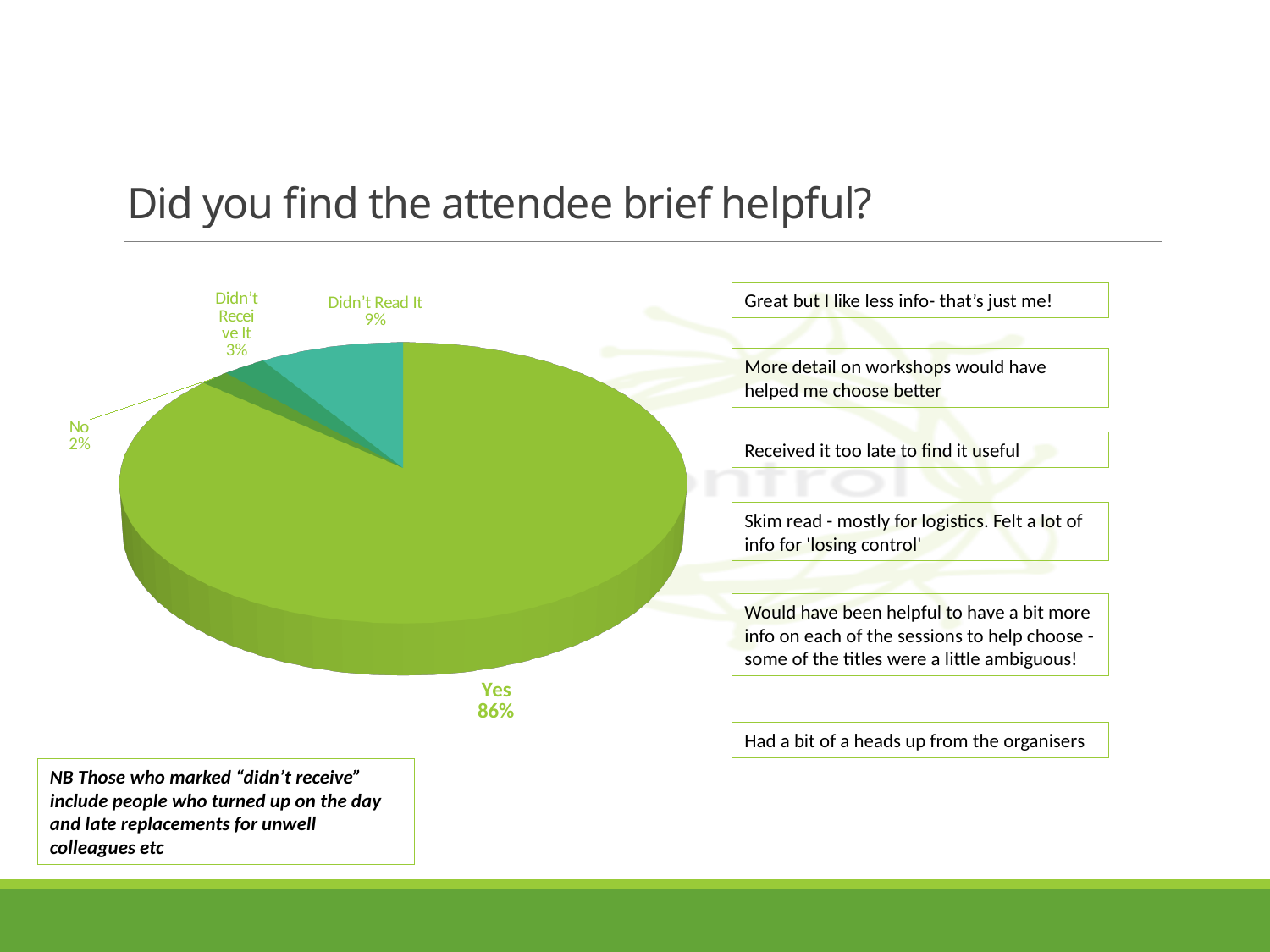
What is the title of the slide containing the pie chart? Did you find the attendee brief helpful? Which response has the largest share of the pie? Yes What percentage of respondents answered "No"? 2% What kind of chart is shown on the slide? Pie chart What is the difference in percentage points between "Yes" and "Didn't Read It"? 77 Which response has the smallest share of the pie? No What percentage of respondents answered "Yes"? 86% Which is larger, the share for "Didn't Read It" or the share for "Didn't Receive It"? Didn't Read It How many slices does the pie chart have? 4 What is the combined share of "No" and "Didn't Receive It"? 5% What percentage of respondents answered "Didn't Receive It"? 3% What percentage of respondents answered "Didn't Read It"? 9%